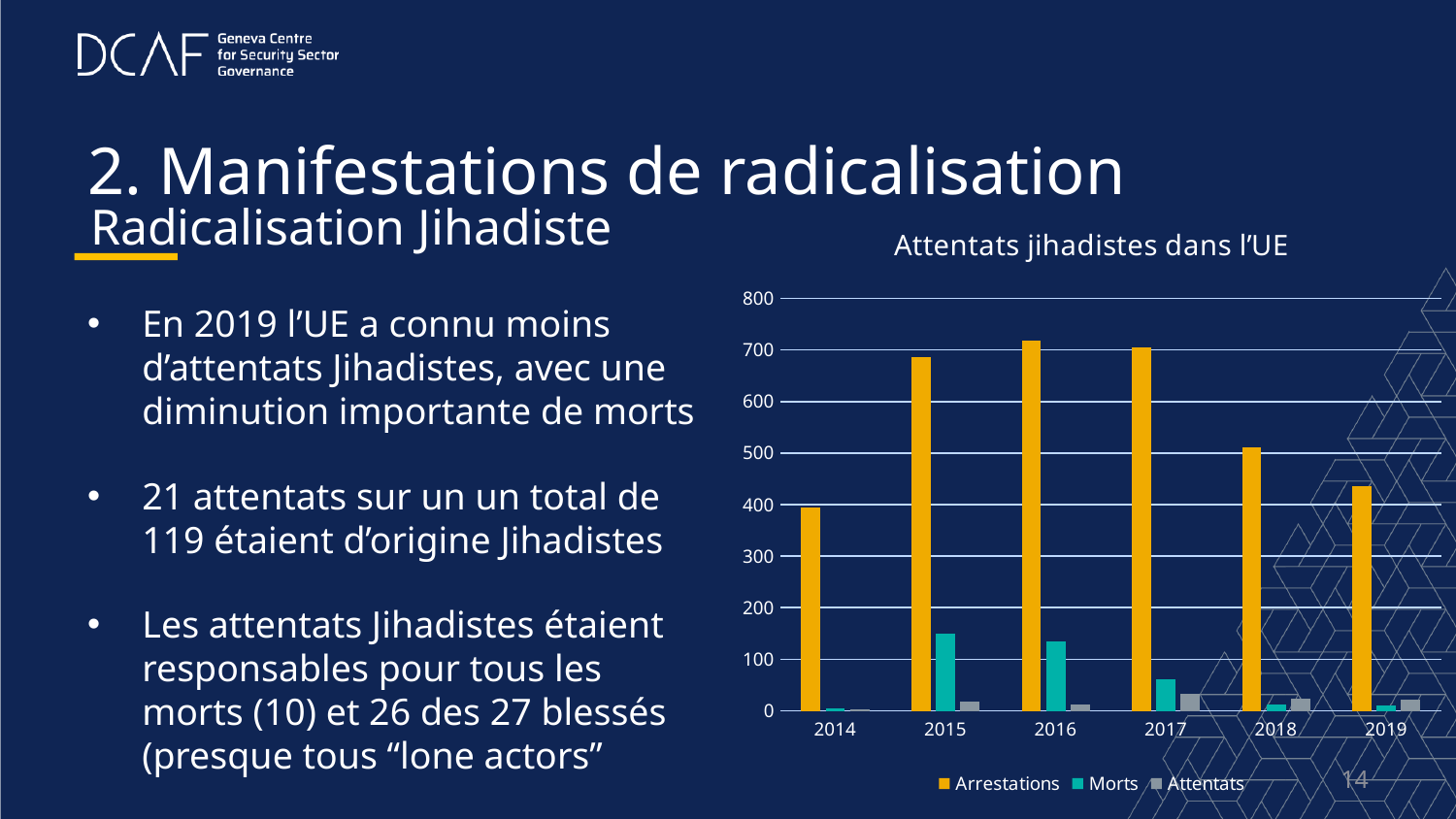
Is the value for Arrestations in 2019 greater or less than 500? less How many series does the chart legend list? 3 How many years are shown on the x axis of the chart? 6 What kind of chart is shown on the slide? bar chart Is the value for Arrestations in 2016 greater or less than 700? greater Which is larger, Arrestations in 2015 or Arrestations in 2019? Arrestations in 2015 In which year is the Arrestations value lowest? 2014 Is the value for Morts in 2015 greater or less than 100? greater Do the Arrestations values rise or fall from 2017 to 2019? fall What is the title of the chart? Attentats jihadistes dans l'UE Which series is shown in yellow in the chart? Arrestations